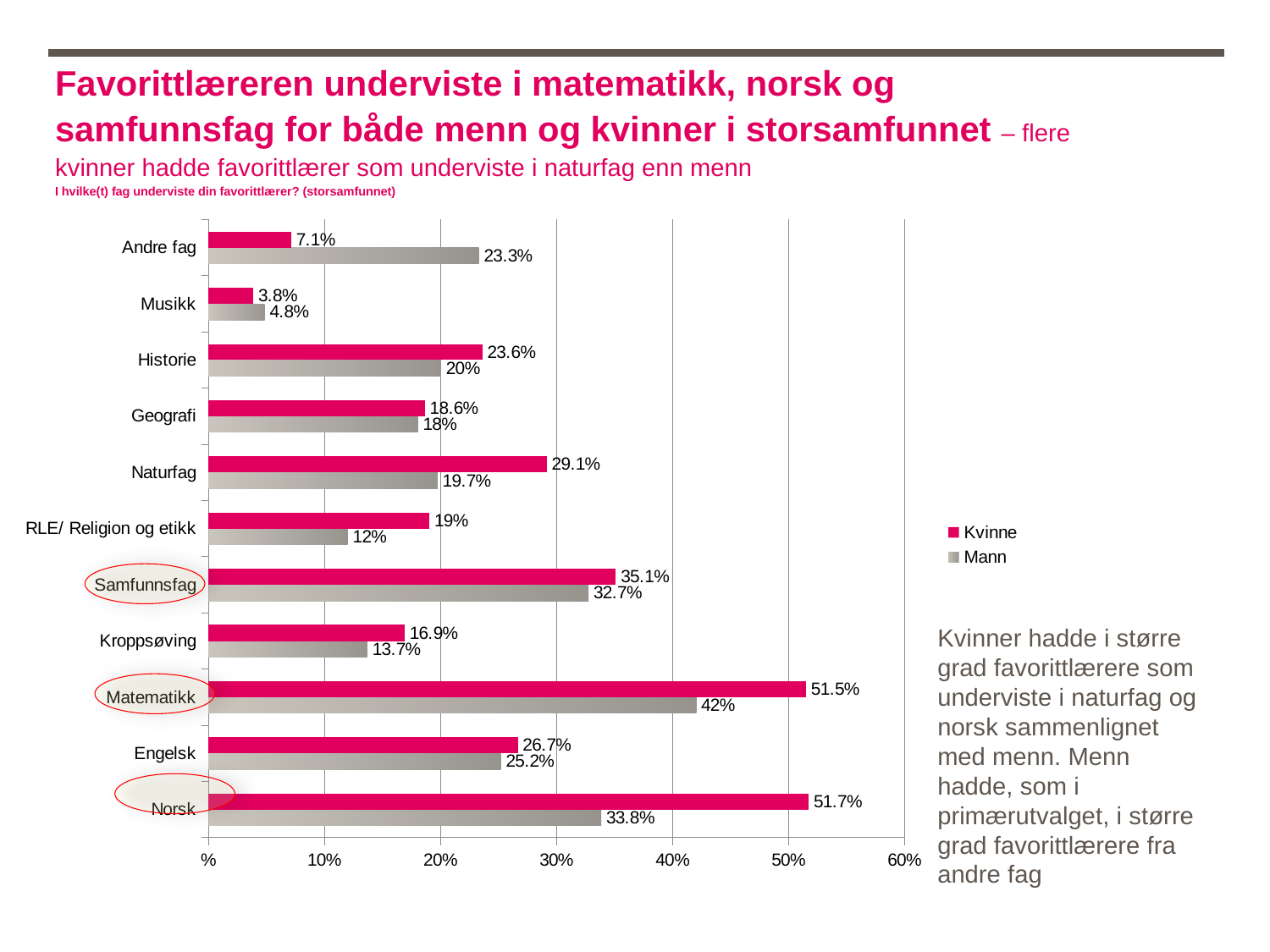
For Andre fag, which is larger: the Kvinne value or the Mann value? Mann What is the Mann value for Matematikk? 42% Is the Kvinne value for Matematikk greater or less than 50%? greater How many series does the legend list? 2 What is the Kvinne value for RLE/ Religion og etikk? 19% What is the difference between the Kvinne and Mann values for Naturfag? 9.4 percentage points What is the Kvinne value for Naturfag? 29.1% How many subject categories are shown on the chart? 11 Which category has the highest Mann value? Matematikk Which category has the lowest Kvinne value? Musikk What is the Mann value for Andre fag? 23.3% What is the difference between the Kvinne and Mann values for Norsk? 17.9 percentage points